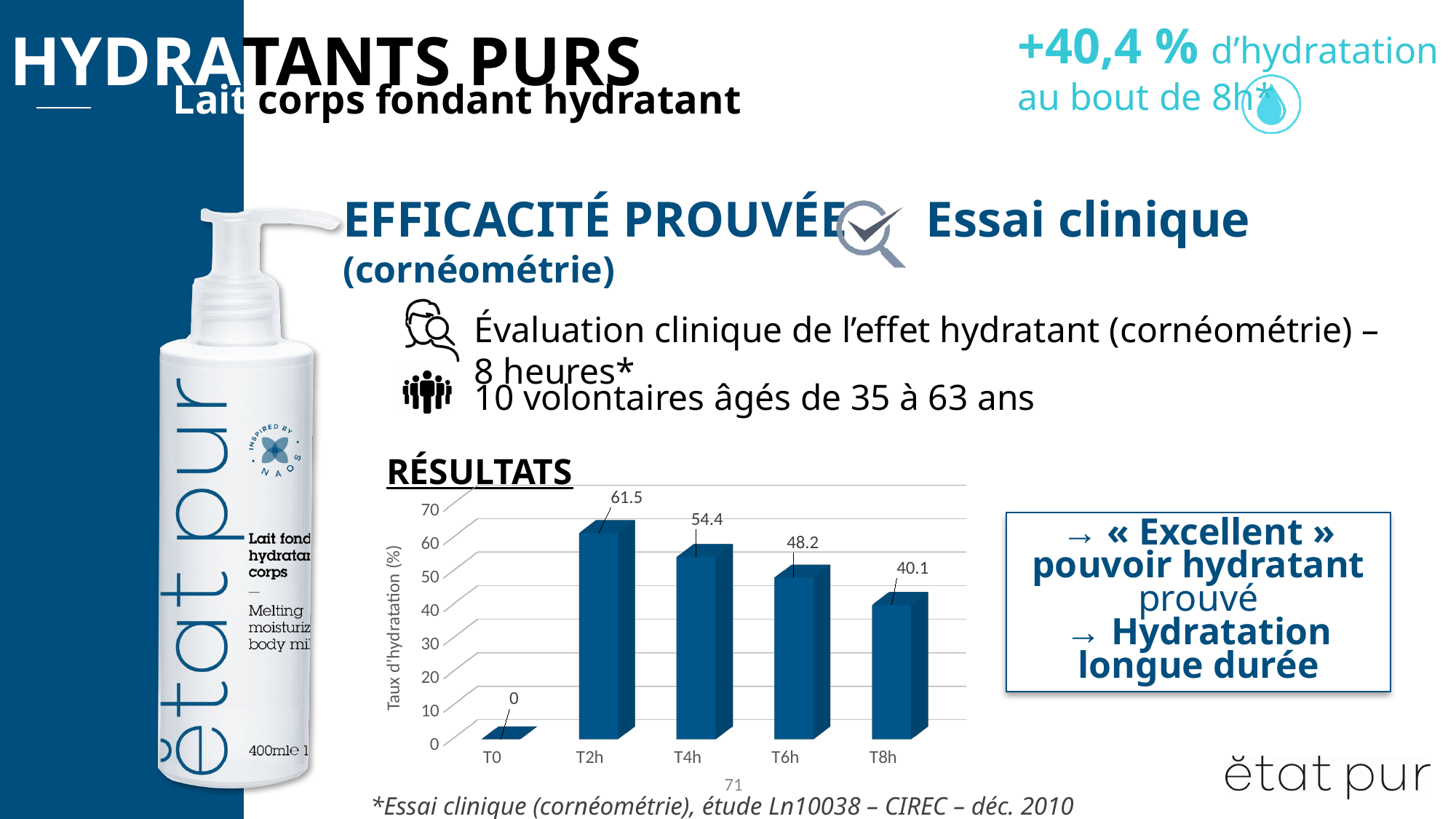
Which is larger, the value for T4h or the value for T6h? T4h Which category has the lowest value? T0 How many categories are shown on the x axis? 5 Do the values rise or fall from T2h to T8h? fall Which category has the highest value? T2h Is the value for T6h greater or less than 40? greater What is the difference between the values for T2h and T8h? 21.4 What is the value for T2h? 61.5 What is the value for T0? 0 What is the value for T8h? 40.1 What is the label of the vertical axis? Taux d'hydratation (%) What kind of chart is shown? bar chart